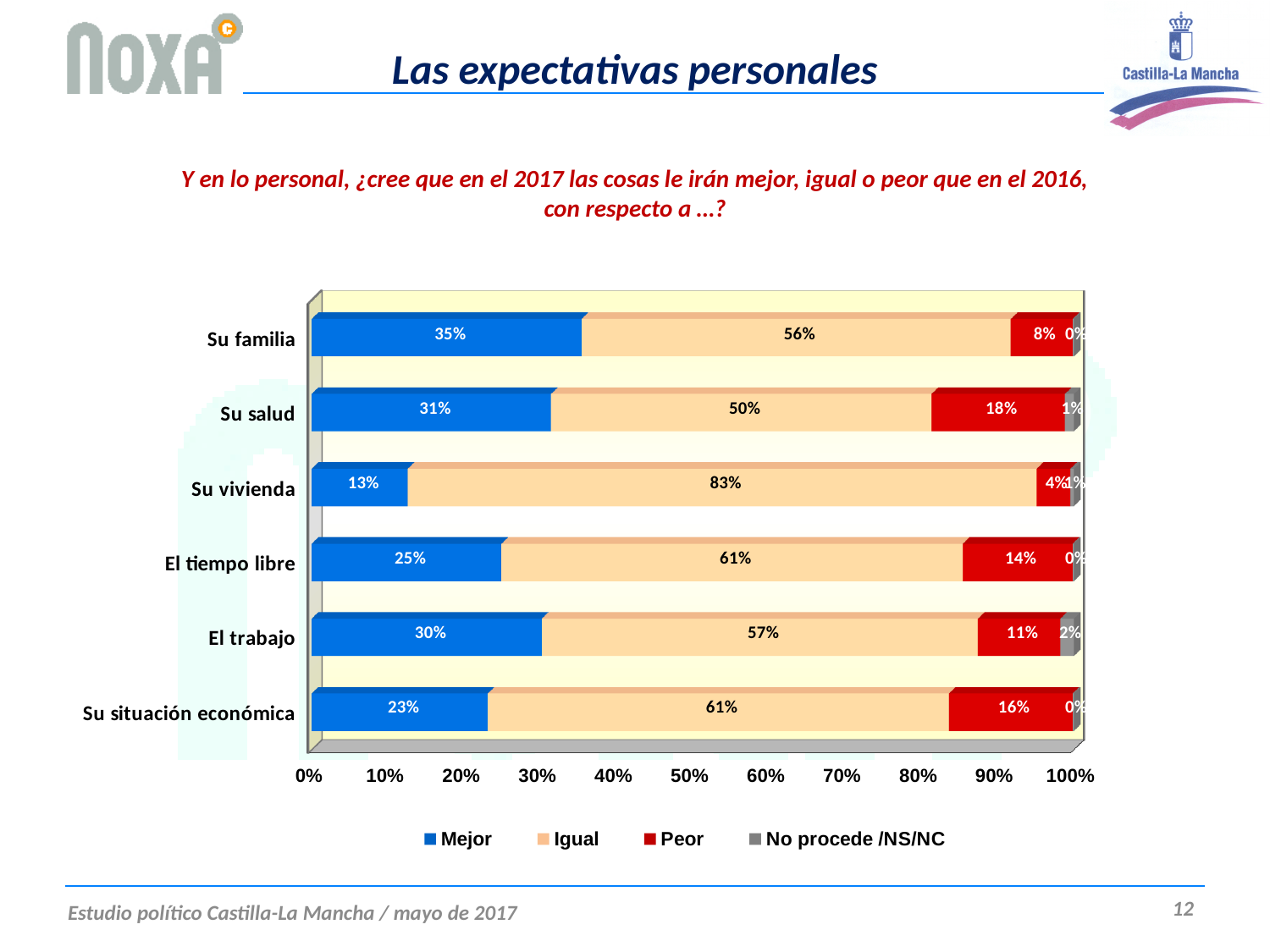
What is the 'Mejor' value for 'Su situación económica'? 23% Which is larger: the 'Peor' value for 'El tiempo libre' or for 'El trabajo'? El tiempo libre How many categories are shown on the chart? 6 What kind of chart is shown on the slide? Stacked bar chart What percentage of respondents expect things to go 'Mejor' for 'Su familia'? 35% Which category has the highest 'Igual' value? Su vivienda Which category has the lowest 'Mejor' value? Su vivienda Which category has the highest 'Peor' value? Su salud How many series does the legend list? 4 What is the 'Igual' value for 'Su vivienda'? 83% What is the difference between the 'Mejor' values for 'Su familia' and 'Su situación económica'? 12% What is the 'Peor' value for 'Su salud'? 18%